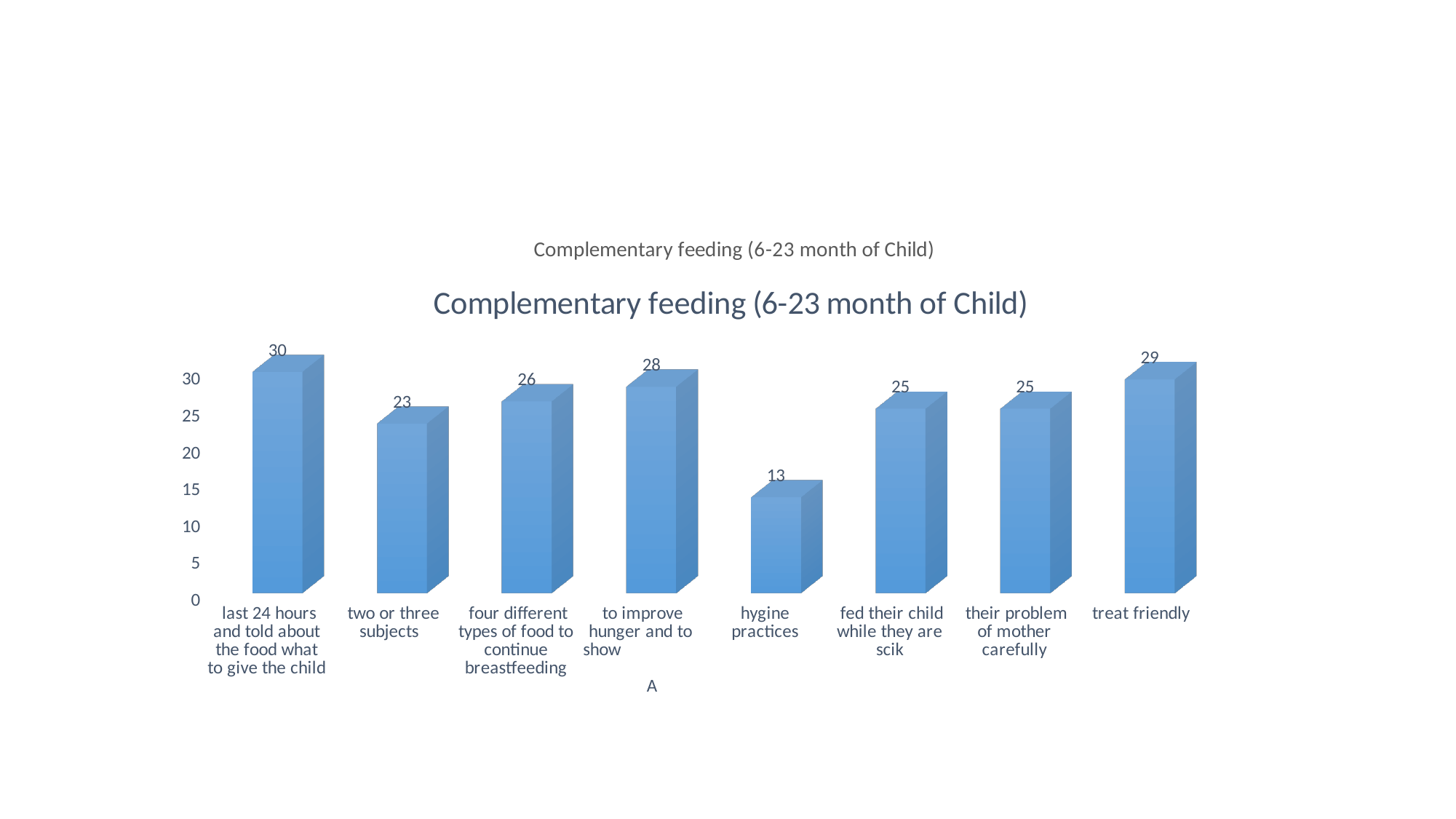
What kind of chart is shown on the slide? bar chart How many categories are shown in the chart? 8 What is the difference between the values for "last 24 hours and told about the food what to give the child" and "treat friendly"? 1 Which is larger, the value for "four different types of food to continue breastfeeding" or the value for "fed their child while they are scik"? four different types of food to continue breastfeeding What is the difference between the values for "to improve hunger and to show" and "hygine practices"? 15 What is the value for "hygine practices"? 13 Which category has the lowest value? hygine practices What is the title of the chart? Complementary feeding (6-23 month of Child) What is the value for "two or three subjects"? 23 What is the value for "treat friendly"? 29 Which category has the highest value? last 24 hours and told about the food what to give the child